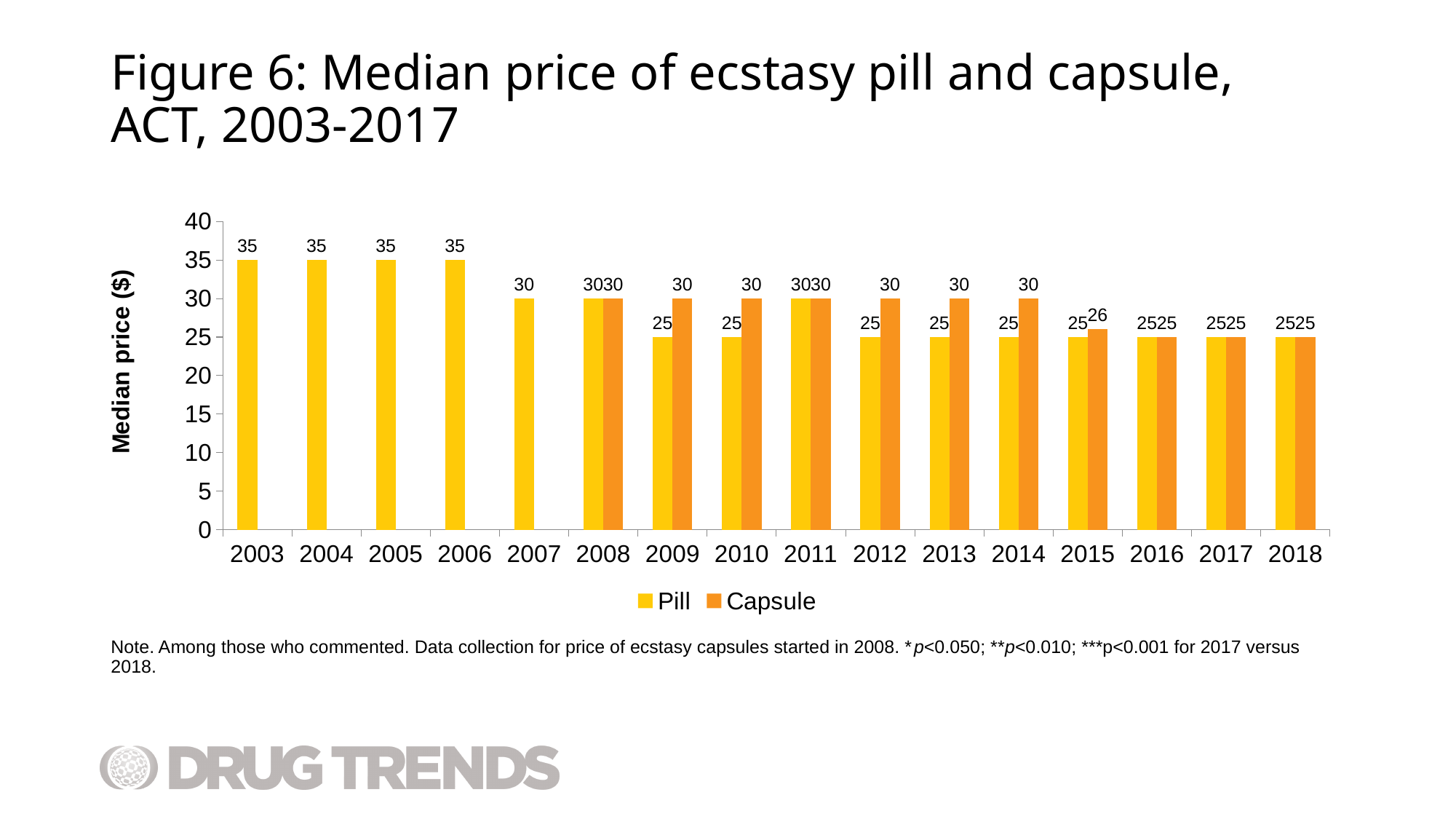
What is the median price of an ecstasy capsule in 2012? 30 Does the median pill price generally rise or fall from 2003 to 2018? Fall What kind of chart is shown on the slide? Bar chart How many series does the legend list? 2 What is the label on the y axis? Median price ($) What is the median price of an ecstasy pill in 2003? 35 How many years are shown on the x axis? 16 Which is higher in 2010, the pill price or the capsule price? Capsule What is the difference between the capsule price and the pill price in 2014? 5 What is the median price of an ecstasy pill in 2009? 25 What is the difference between the pill price in 2003 and the pill price in 2018? 10 What is the median price of an ecstasy capsule in 2015? 26